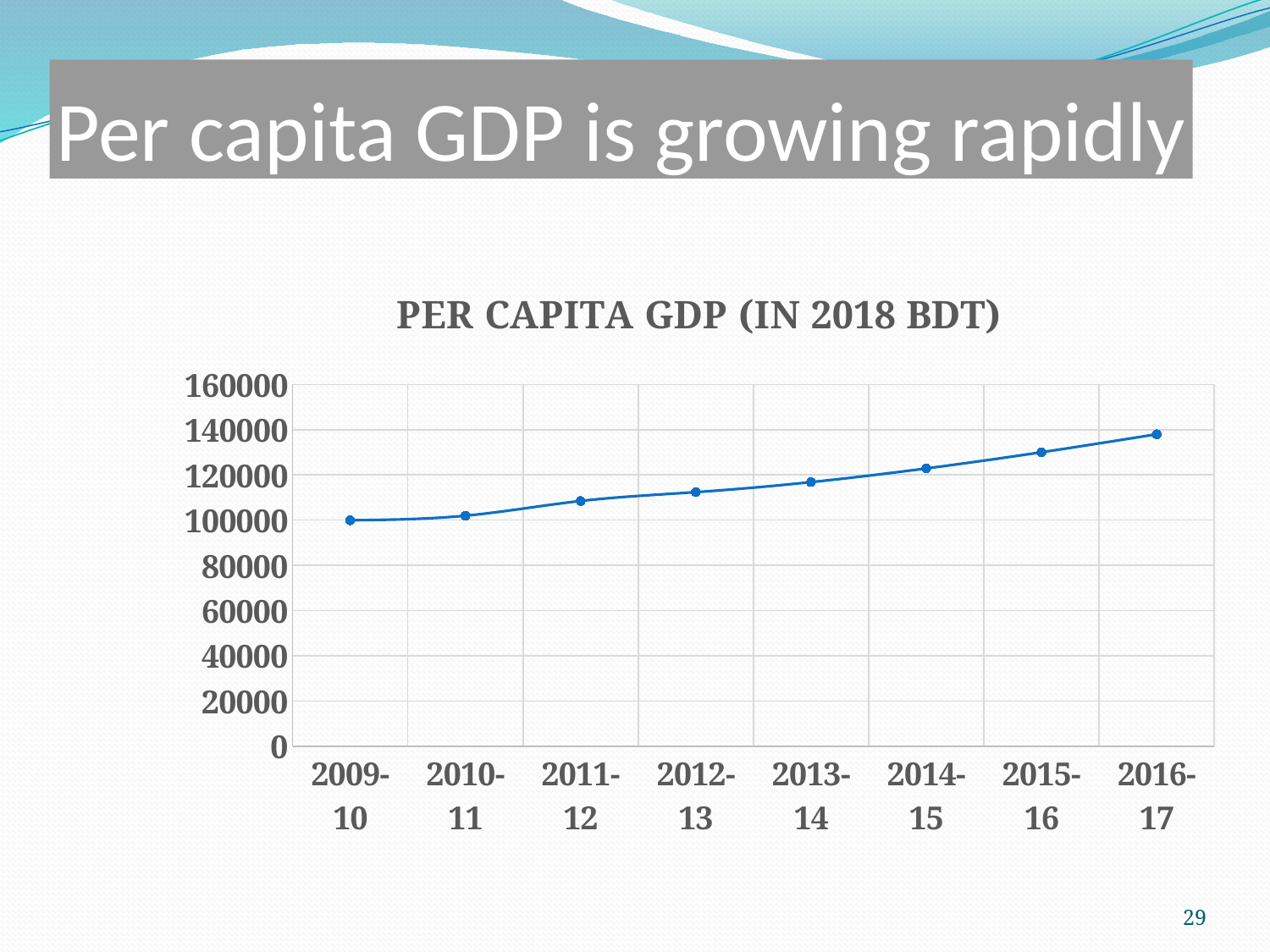
Which is larger, the value for 2012-13 or the value for 2014-15? 2014-15 Do the per capita GDP values rise or fall from 2009-10 to 2016-17? rise Is the value for 2013-14 greater or less than 120000? less Which fiscal year has the highest per capita GDP? 2016-17 Is the value for 2011-12 greater or less than 100000? greater What kind of chart is shown on the slide? line chart What is the highest value shown on the y axis? 160000 Which fiscal year has the lowest per capita GDP? 2009-10 Is the value for 2015-16 greater or less than 120000? greater What is the title of the chart? PER CAPITA GDP (IN 2018 BDT) How many fiscal years are plotted on the x axis? 8